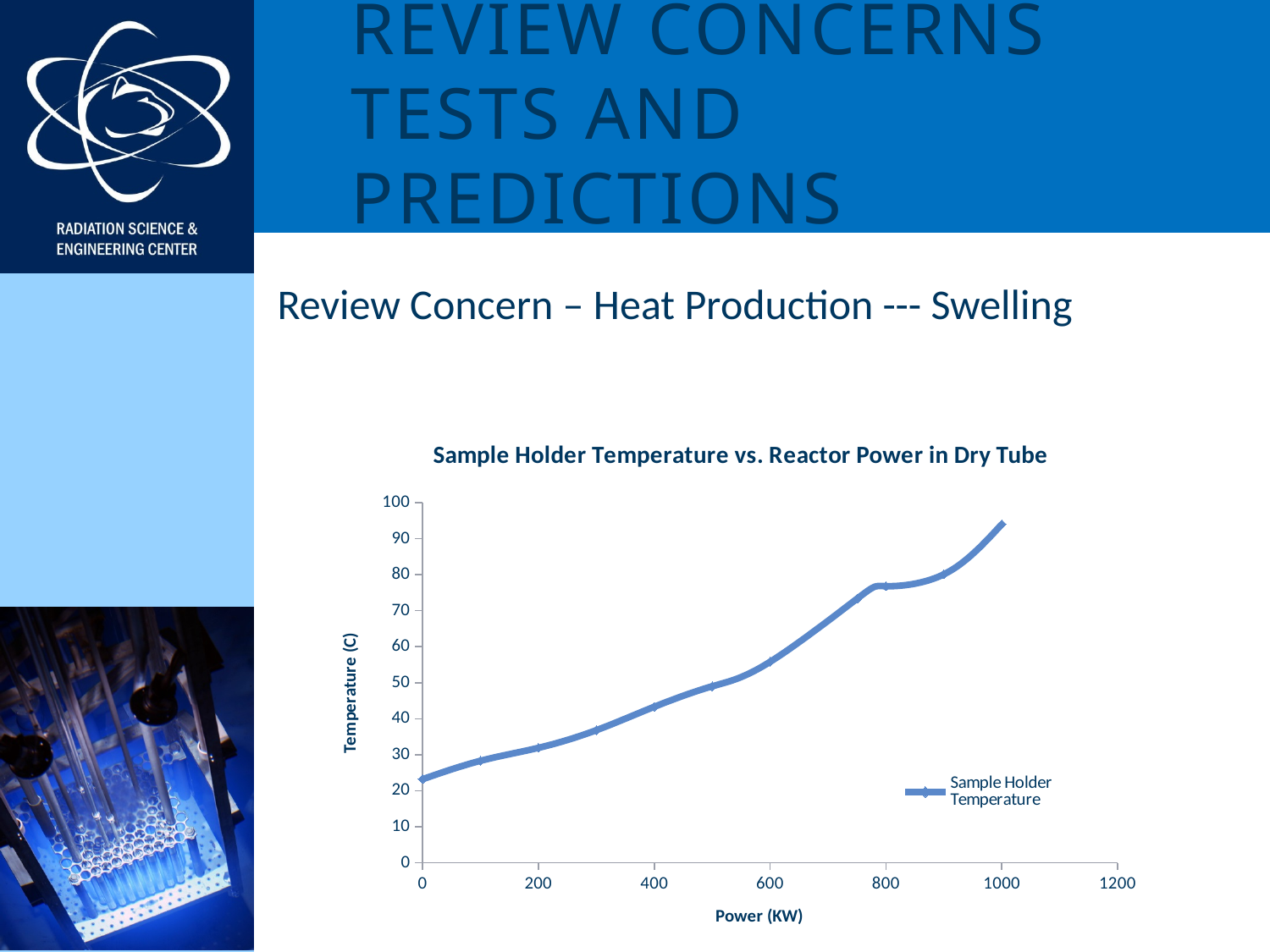
What is the label of the x axis? Power (KW) Is the sample holder temperature at 0 KW greater or less than 30? less Which is larger, the sample holder temperature at 400 KW or at 800 KW? 800 KW What is the title of the chart? Sample Holder Temperature vs. Reactor Power in Dry Tube Is the sample holder temperature at 1000 KW greater or less than 90? greater What kind of chart is shown on the slide? line chart How many series does the chart's legend list? 1 Does the sample holder temperature rise or fall as reactor power increases along the x axis? rise At which power value is the sample holder temperature lowest? 0 Is the sample holder temperature at 800 KW greater or less than 70? greater At which power value is the sample holder temperature highest? 1000